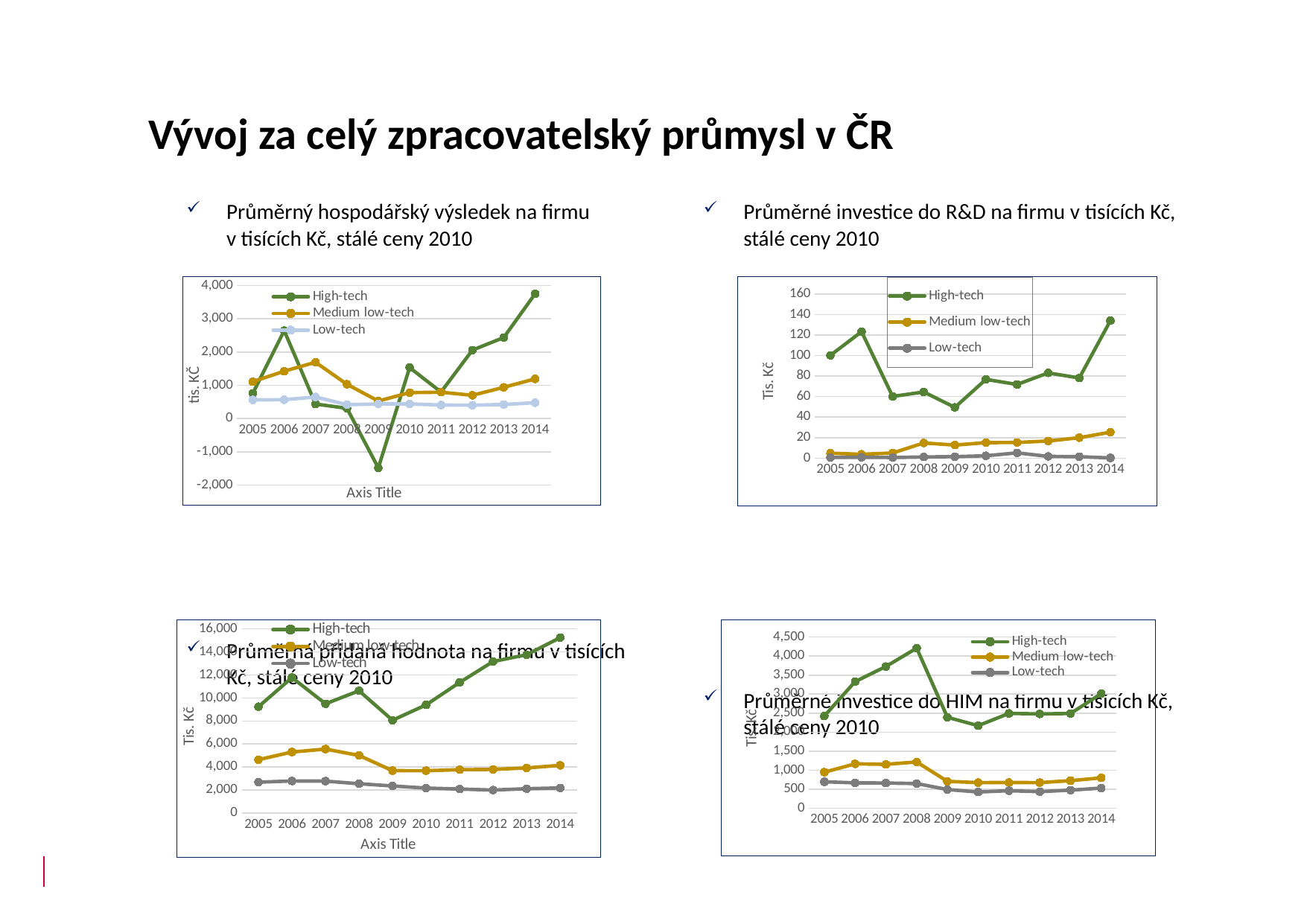
In the top-left chart (Průměrný hospodářský výsledek na firmu), in which year is the High-tech series at its lowest? 2009 In the top-left chart (Průměrný hospodářský výsledek na firmu), is the value for High-tech in 2009 greater or less than 0? less In the top-left chart (Průměrný hospodářský výsledek na firmu), how many series does the legend list? 3 In the bottom-right chart (Průměrné investice do HIM na firmu), in which year is the High-tech series at its highest? 2008 In the top-left chart (Průměrný hospodářský výsledek na firmu), which series has the higher value in 2006, High-tech or Medium low-tech? High-tech In the bottom-left chart (Průměrná přidaná hodnota na firmu), is the value for High-tech in 2014 greater or less than 14,000? greater In the top-right chart (Průměrné investice do R&D na firmu), how many years are shown on the x axis? 10 In the top-right chart (Průměrné investice do R&D na firmu), in which year is the High-tech series at its highest? 2014 In the top-right chart (Průměrné investice do R&D na firmu), is the value for High-tech in 2014 greater or less than 120? greater What kind of chart is the top-left chart (Průměrný hospodářský výsledek na firmu)? line chart In the bottom-right chart (Průměrné investice do HIM na firmu), does the Medium low-tech series rise or fall from 2008 to 2009? fall In the bottom-left chart (Průměrná přidaná hodnota na firmu), in which year is the High-tech series at its lowest? 2009